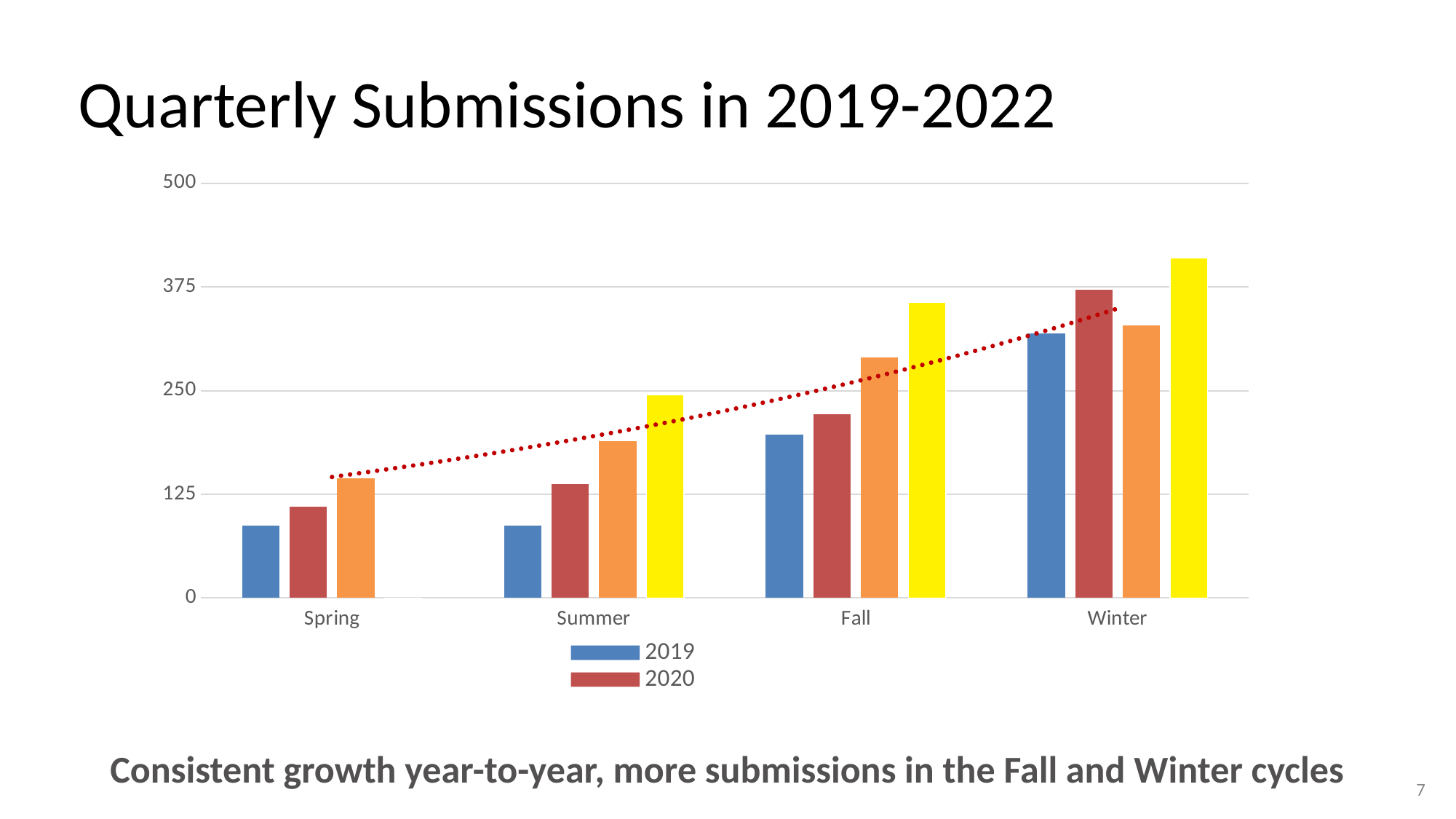
For Fall, which is larger: the 2019 value or the 2020 value? 2020 Is the 2019 value for Winter greater or less than 250? greater How many series does the chart's legend list? 2 Is the 2019 value for Spring greater or less than 125? less Do the 2020 values rise or fall from Spring to Winter? Rise Which category has the highest value for the 2019 series? Winter What kind of chart is shown on the slide? Bar chart Which category has the lowest value for the 2020 series? Spring What is the title of the chart? Quarterly Submissions in 2019-2022 What colour represents the 2019 series in the chart? Blue Is the 2019 value for Fall greater or less than 250? less How many categories are shown on the x axis of the chart? 4